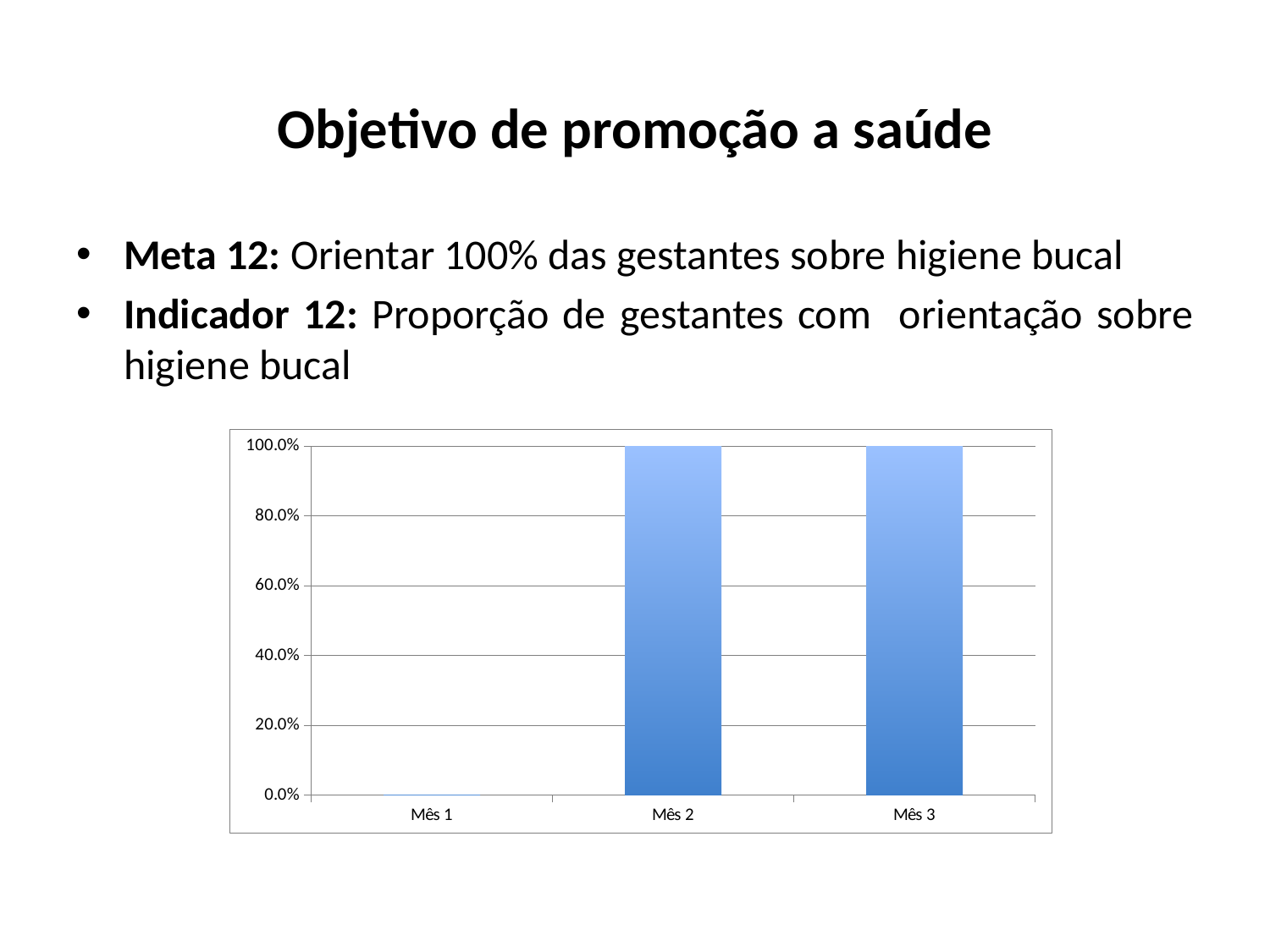
What kind of chart is shown on the slide? bar chart What is the difference between the values for Mês 2 and Mês 3? 0.0% Is the value for Mês 3 greater or less than 80.0%? greater Which is larger, the value for Mês 1 or the value for Mês 2? Mês 2 What is the value for Mês 3 in the chart? 100.0% What is the highest value shown on the y axis of the chart? 100.0% What is the label of the first category on the x axis? Mês 1 What is the value for Mês 2 in the chart? 100.0% Is the value for Mês 1 greater or less than 20.0%? less How many categories are shown on the x axis of the chart? 3 Which category has the lowest value in the chart? Mês 1 Does the value rise or fall from Mês 1 to Mês 2? rise